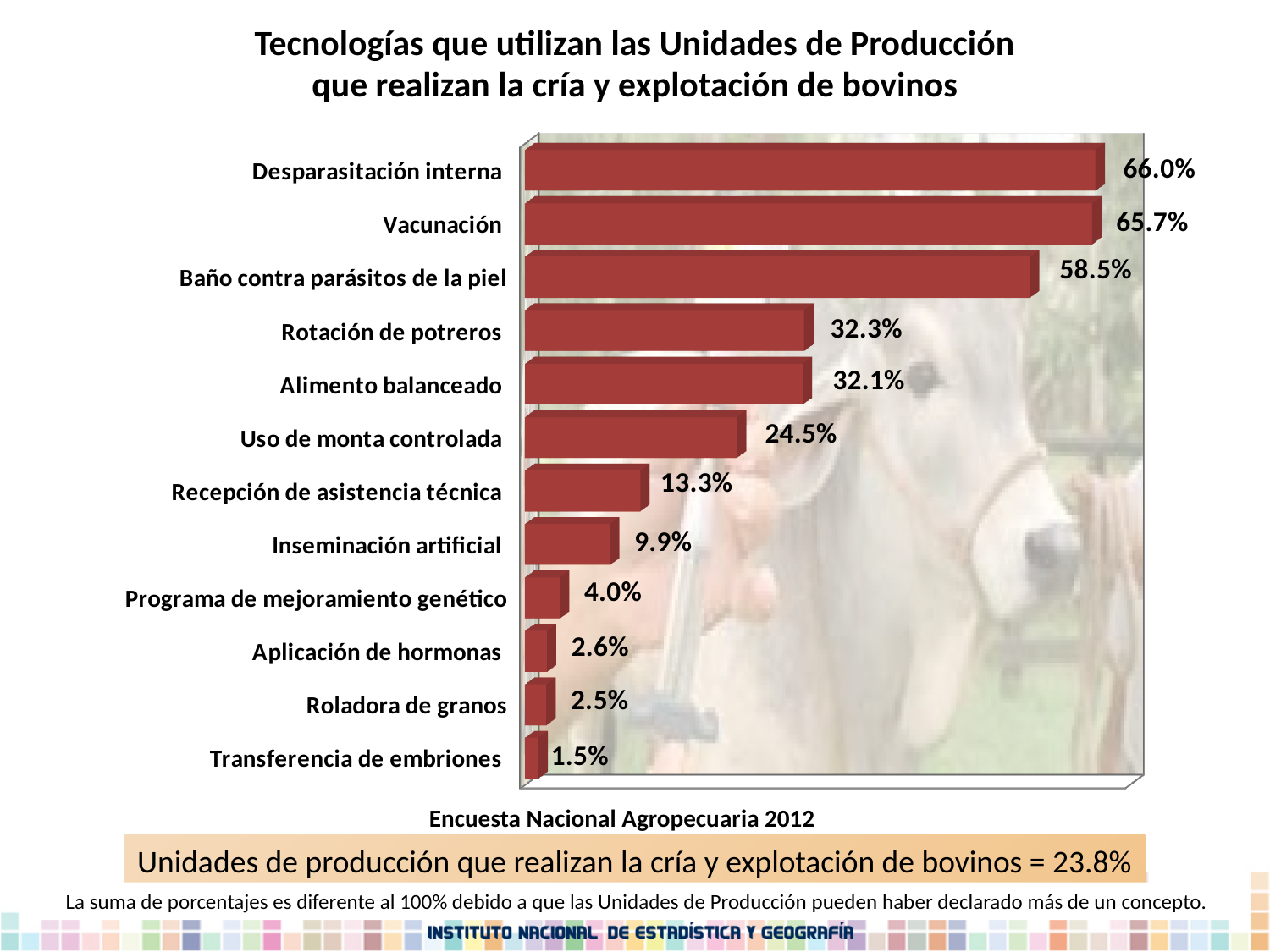
What is the source of the data cited below the chart? Encuesta Nacional Agropecuaria 2012 What is the value shown for Rotación de potreros? 32.3% Which has a larger value, Uso de monta controlada or Recepción de asistencia técnica? Uso de monta controlada What percentage is shown for Inseminación artificial? 9.9% According to the slide, what percentage of production units carry out cattle breeding and exploitation? 23.8% Which technology has the highest percentage in the chart? Desparasitación interna What percentage of production units use Desparasitación interna? 66.0% What type of chart is shown on the slide? Bar chart What is the difference between the values for Aplicación de hormonas and Roladora de granos? 0.1% How many technologies (categories) are shown in the chart? 12 Which technology has the lowest percentage in the chart? Transferencia de embriones What is the difference between the percentages for Vacunación and Baño contra parásitos de la piel? 7.2%